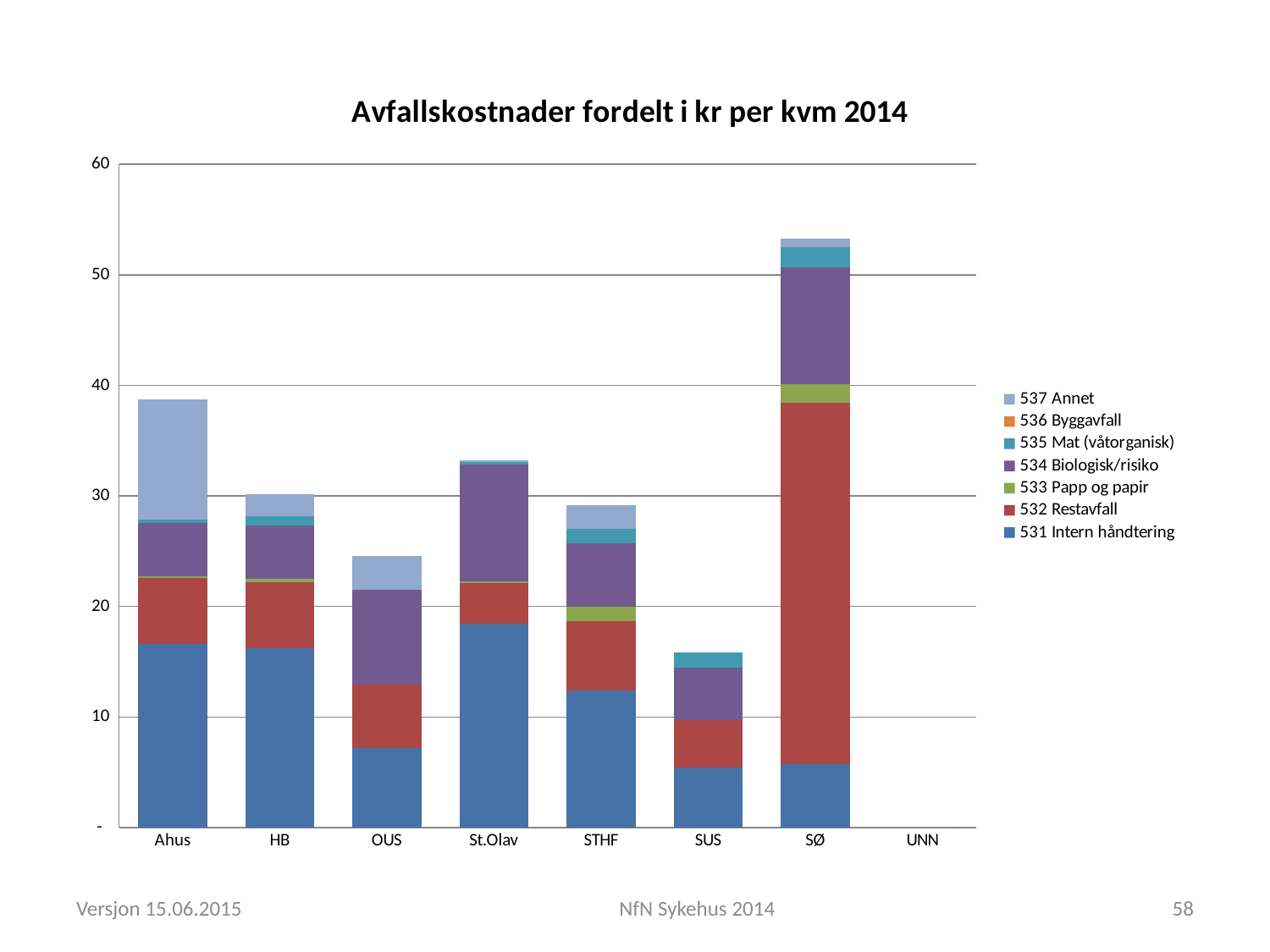
Which hospital has the largest 532 Restavfall segment? SØ Is the total for OUS greater or less than 30? less What kind of chart is shown on the slide? Stacked bar chart Which has the larger total bar, Ahus or HB? Ahus What is the title of the chart? Avfallskostnader fordelt i kr per kvm 2014 Is the total for SUS greater or less than 20? less How many hospital categories are shown on the x axis? 8 Is the total for Ahus greater or less than 30? greater Which hospital has the largest 537 Annet segment? Ahus How many series does the legend list? 7 Which hospital has the highest total stacked bar? SØ